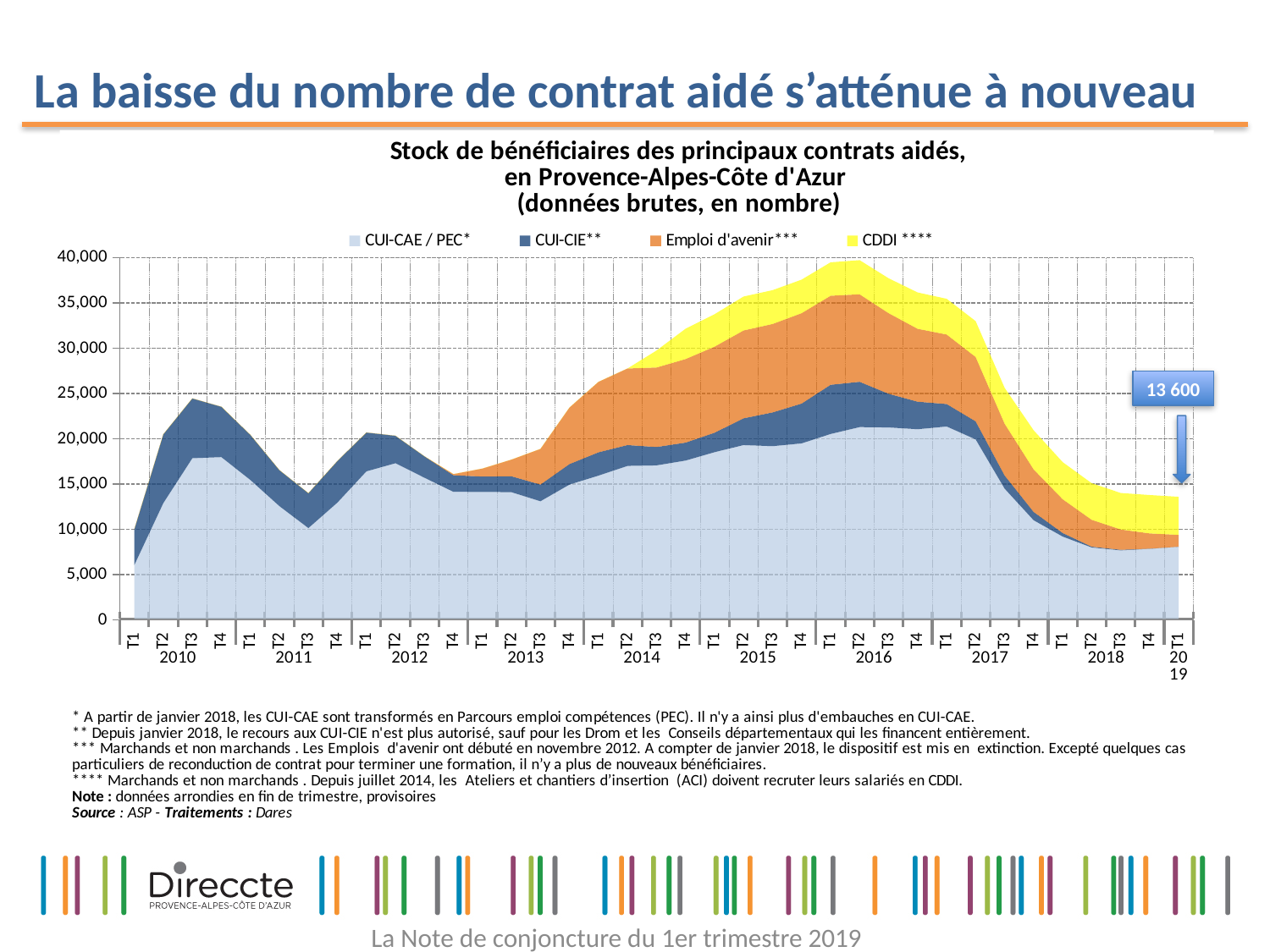
What total value is labelled on the chart for T1 2019? 13 600 Which series is listed first in the legend? CUI-CAE / PEC* Which series is shown in yellow in the legend? CDDI **** In which year does the total stock of beneficiaries reach its highest level? 2016 Does the total stock of beneficiaries rise or fall between 2016 and T1 2019? fall What kind of chart is shown on the slide? Stacked area chart Is the total stock of beneficiaries at T2 2016 greater or less than 35,000? greater Is the total stock of beneficiaries at T1 2010 greater or less than 15,000? less Is the CUI-CAE / PEC* value at T1 2019 greater or less than 10,000? less How many years are labelled on the x axis? 10 How many series does the legend list? 4